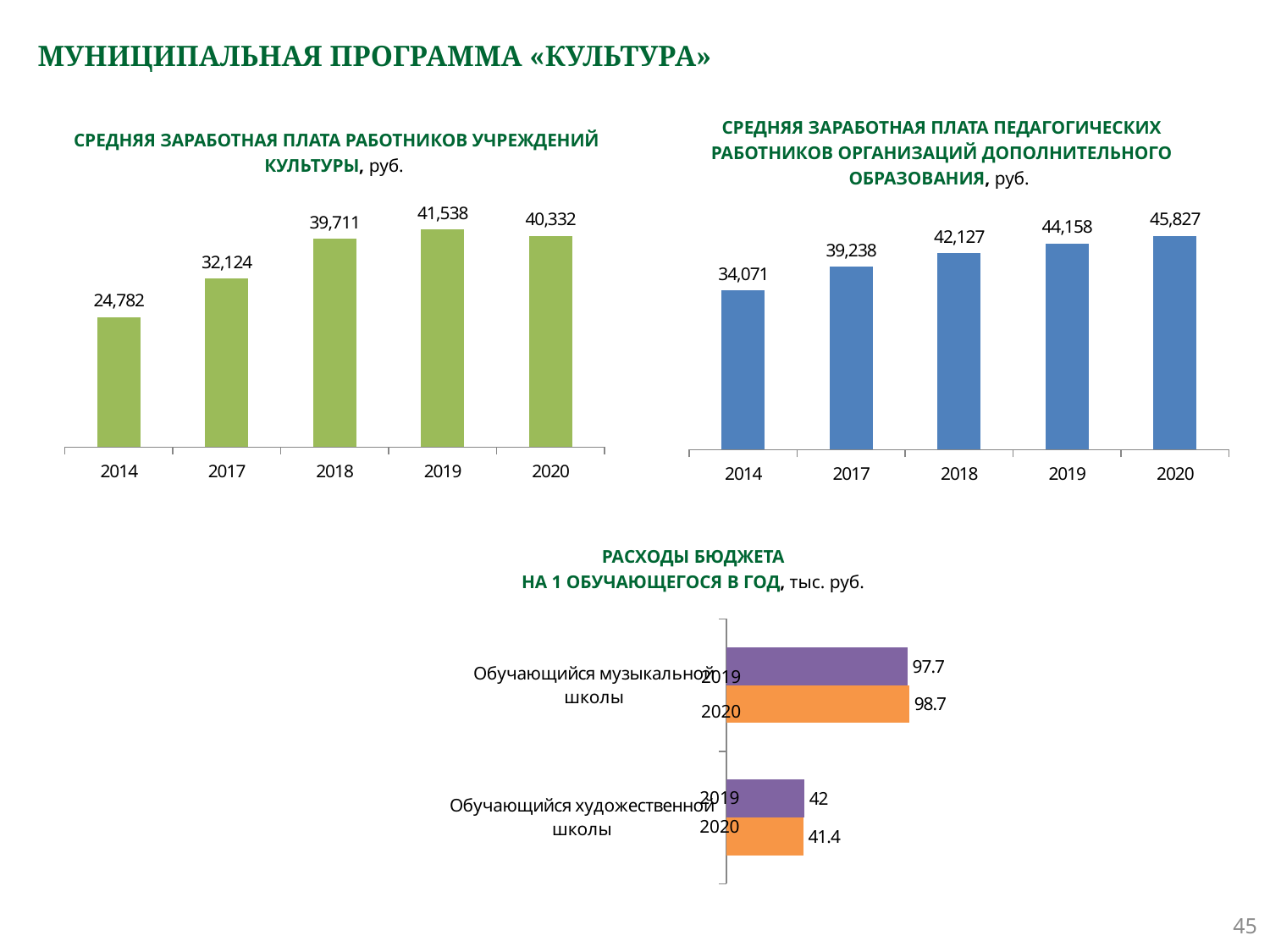
In the top-left chart (average salary of cultural institution workers), what is the value for 2018? 39,711 In the bottom chart (budget expenses per student per year), what is the 2019 value for an art school student? 42 In the top-left chart (average salary of cultural institution workers), what is the difference between the 2019 and 2020 values? 1,206 In the bottom chart (budget expenses per student per year), what is the 2020 value for a music school student? 98.7 In the top-left chart (average salary of cultural institution workers), which year has the highest value? 2019 In the top-right chart (average salary of teaching staff in supplementary education), do the values rise or fall from 2014 to 2020? rise In the top-right chart (average salary of teaching staff in supplementary education), what is the value for 2014? 34,071 In the top-left chart (average salary of cultural institution workers), how many years are shown? 5 Which is larger: the 2020 value in the top-left chart (cultural institution workers) or the 2020 value in the top-right chart (supplementary education teachers)? top-right chart (45,827) What type of chart is the bottom chart (budget expenses per student per year)? bar chart In the top-right chart (average salary of teaching staff in supplementary education), what is the difference between the 2020 and 2014 values? 11,756 In the top-left chart (average salary of cultural institution workers), which year has the lowest value? 2014